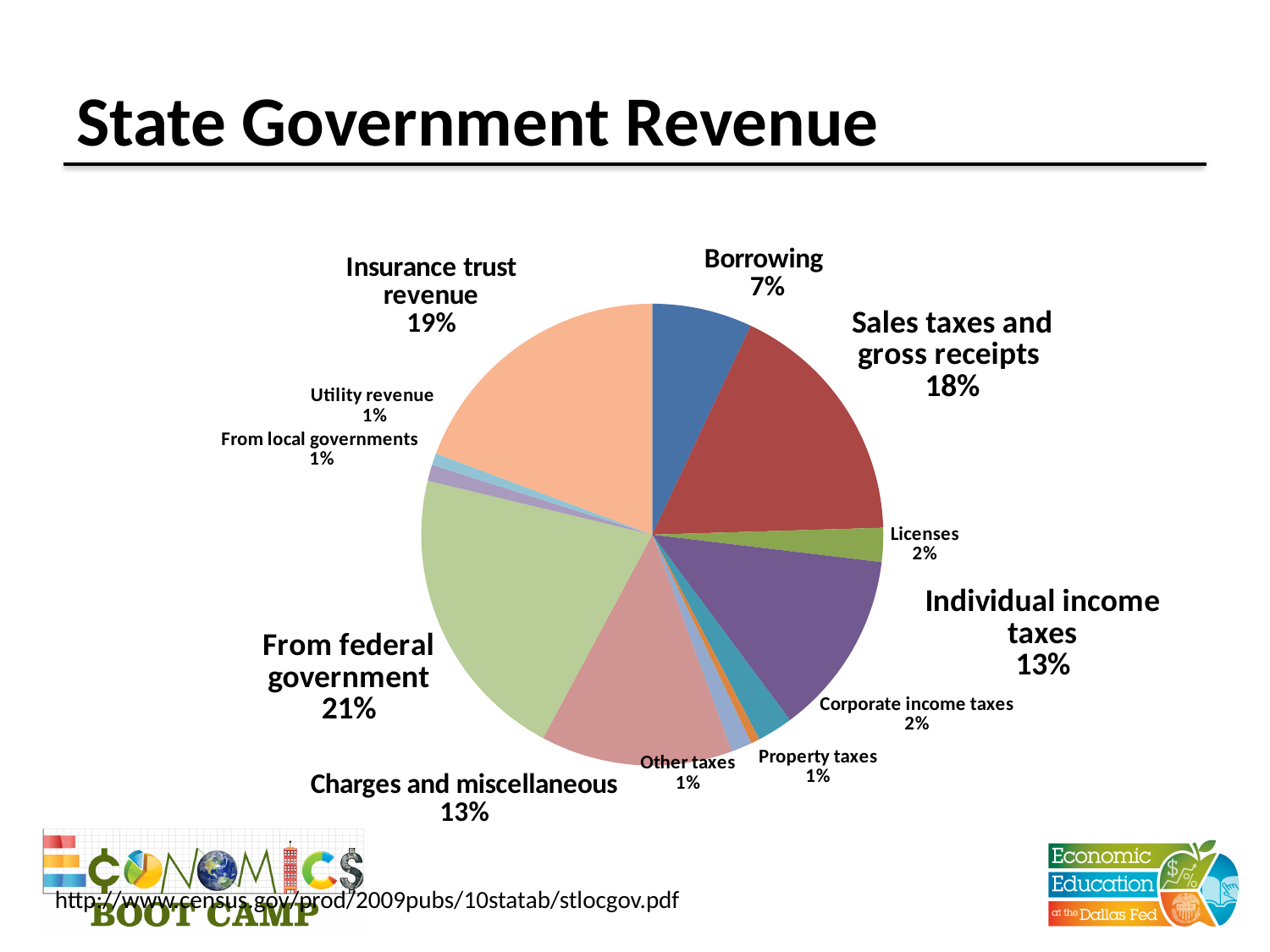
What share of state government revenue comes from the federal government? 21% What type of chart is shown on the slide? Pie chart Which revenue source has the largest share of the pie? From federal government What percentage of state government revenue comes from borrowing? 7% What share of revenue comes from individual income taxes? 13% What is the title of the slide containing the chart? State Government Revenue What percentage of revenue comes from licenses? 2% What percentage of state government revenue is insurance trust revenue? 19% Which is larger: the share from sales taxes and gross receipts or the share from individual income taxes? Sales taxes and gross receipts How many percentage points larger is the federal government share than the insurance trust revenue share? 2 percentage points How many revenue categories are shown in the pie chart? 12 What share of revenue comes from sales taxes and gross receipts? 18%